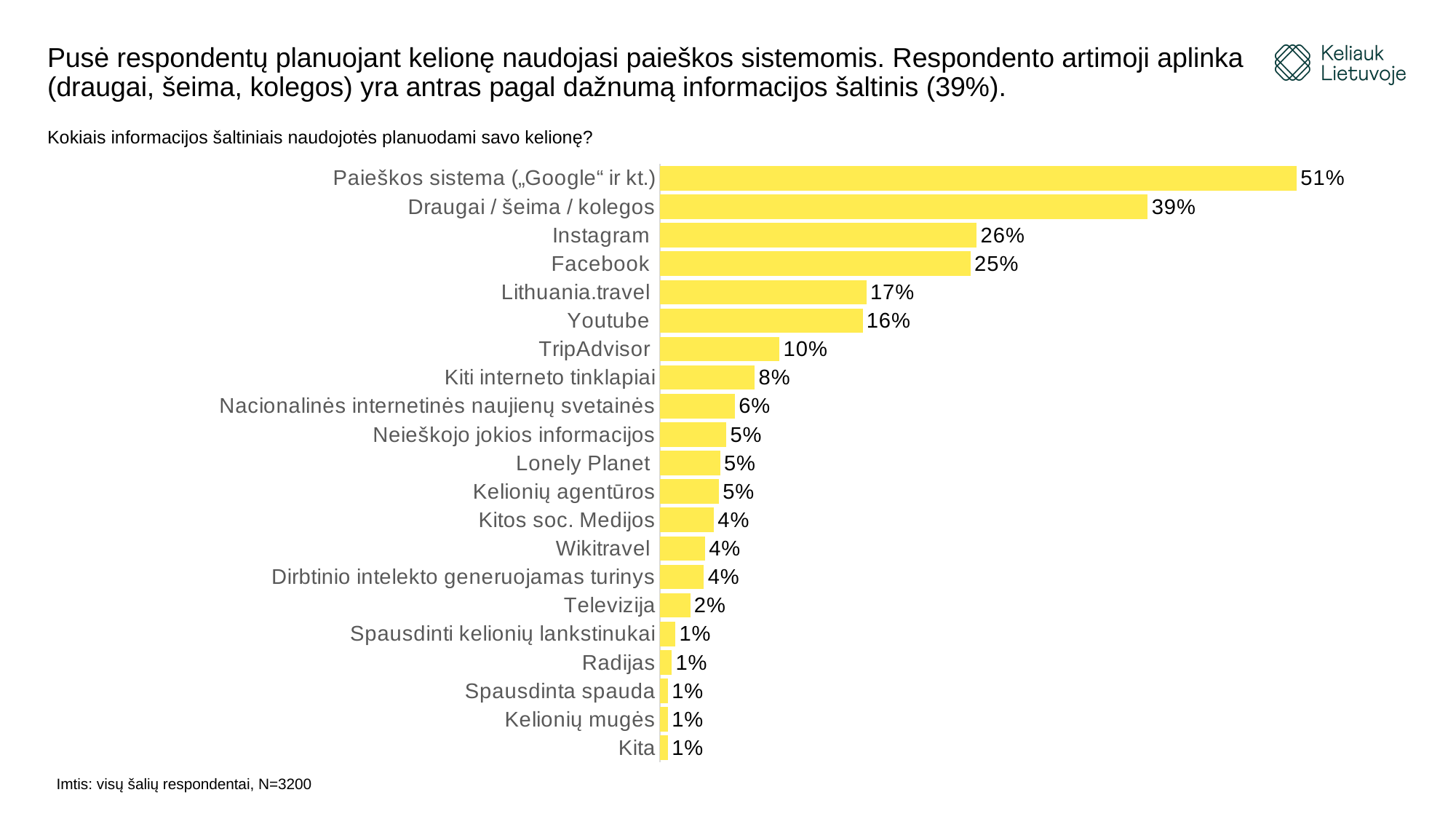
Which is larger, the value for Instagram or the value for Facebook? Instagram What is the value for Lithuania.travel? 17% Which category has the highest value? Paieškos sistema („Google“ ir kt.) What is the value for Televizija? 2% How many categories are shown in the chart? 21 What is the difference between the values for Facebook and Youtube? 9% What is the value for Instagram? 26% What is the difference between the values for Paieškos sistema („Google“ ir kt.) and Draugai / šeima / kolegos? 12% What kind of chart is shown on the slide? Bar chart Which is larger, the value for Kiti interneto tinklapiai or the value for Nacionalinės internetinės naujienų svetainės? Kiti interneto tinklapiai What is the sample size stated below the chart? N=3200 What is the value for TripAdvisor? 10%